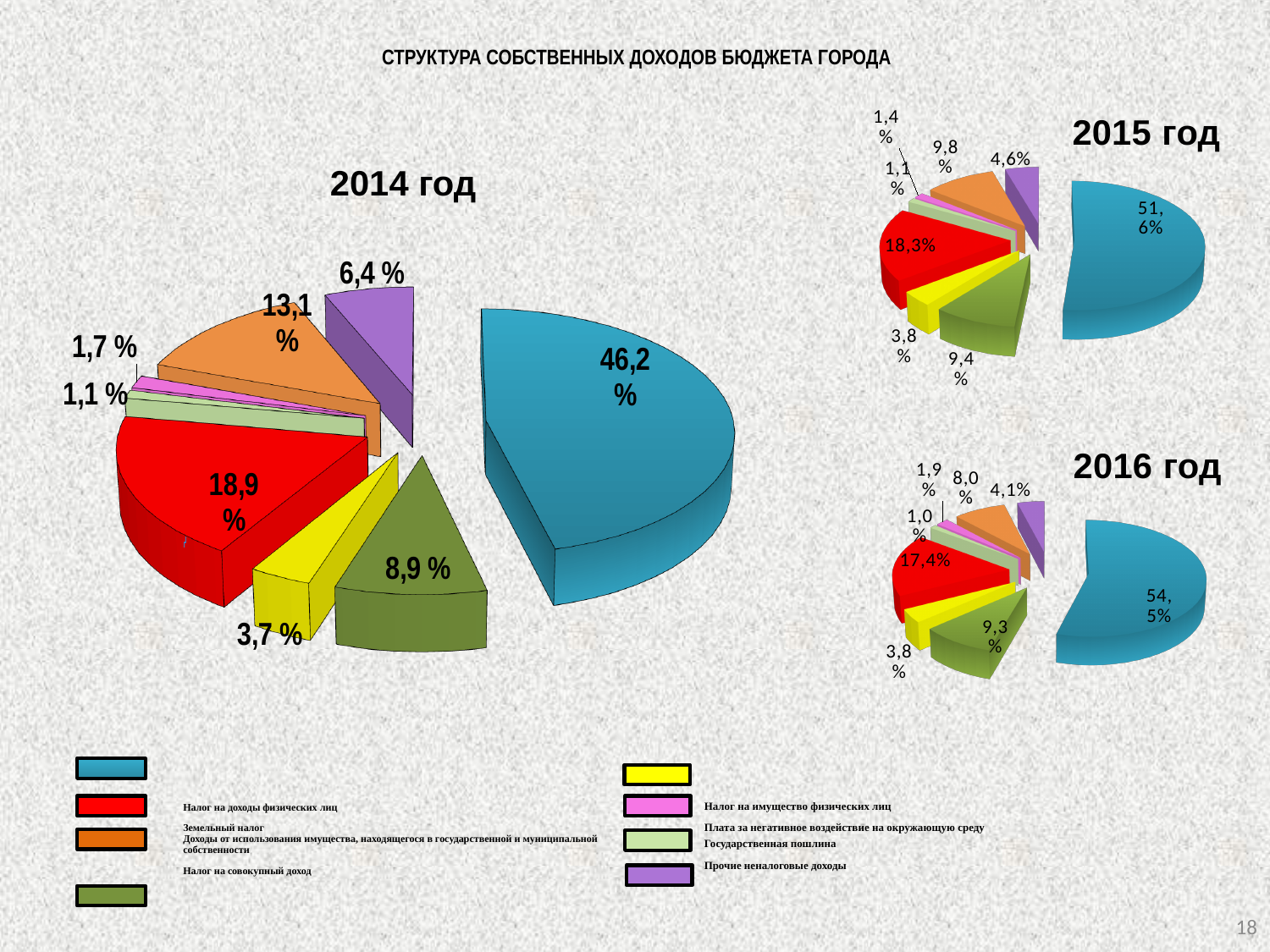
In the 2016 год chart, which slice is the largest? the blue slice, 54,5% What is the title of the slide? СТРУКТУРА СОБСТВЕННЫХ ДОХОДОВ БЮДЖЕТА ГОРОДА In the 2015 год chart, which is larger: the orange slice or the green slice? the orange slice (9,8%) In the 2014 год chart, what is the smallest value shown? 1,1 % How many slices does the 2014 год pie chart have? 8 In the 2016 год chart, what is the value of the red slice? 17,4% In the 2014 год chart, what is the difference between the orange slice (13,1 %) and the green slice (8,9 %)? 4,2 % In the 2014 год chart, what is the value of the largest (blue) slice? 46,2 % Does the share of the largest (blue) slice rise or fall from 2014 to 2016? rise In the 2014 год chart, what is the value of the red slice? 18,9 % In the 2015 год chart, what is the value of the largest (blue) slice? 51,6% What type of chart is used for the 2014 год chart? pie chart